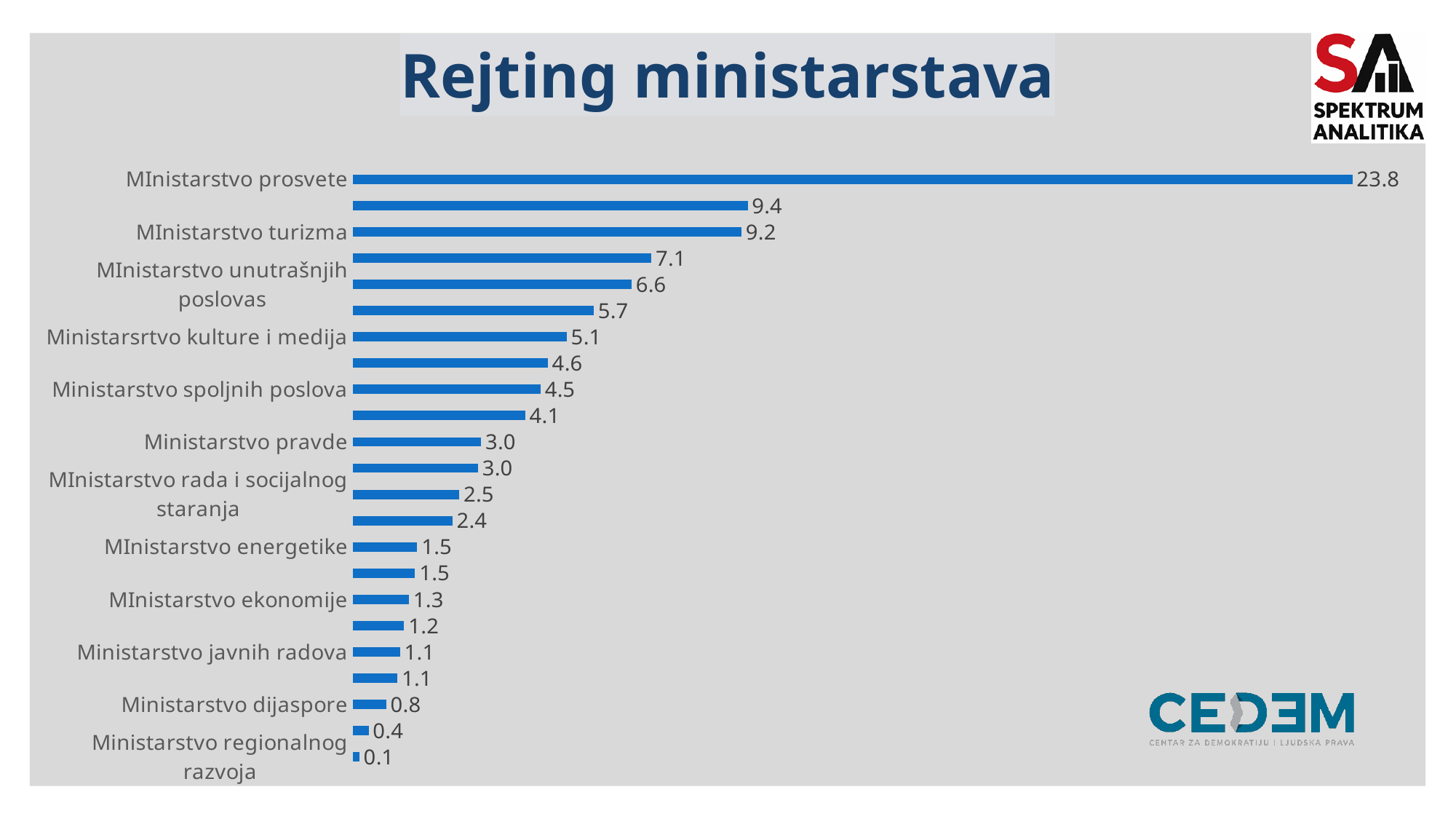
What is the difference between the values for MInistarstvo prosvete and MInistarstvo turizma? 14.6 Which ministry has the highest value? MInistarstvo prosvete What is the title of the chart? Rejting ministarstava What kind of chart is shown on the slide? Bar chart Which ministry has the lowest value? Ministarstvo regionalnog razvoja What is the value for Ministarstvo dijaspore? 0.8 What is the value for Ministarsrtvo kulture i medija? 5.1 How many bars are plotted in the chart? 23 What is the value for MInistarstvo prosvete? 23.8 What is the value for MInistarstvo turizma? 9.2 Which is larger, the value for MInistarstvo turizma or for Ministarstvo spoljnih poslova? MInistarstvo turizma What is the value for Ministarstvo pravde? 3.0